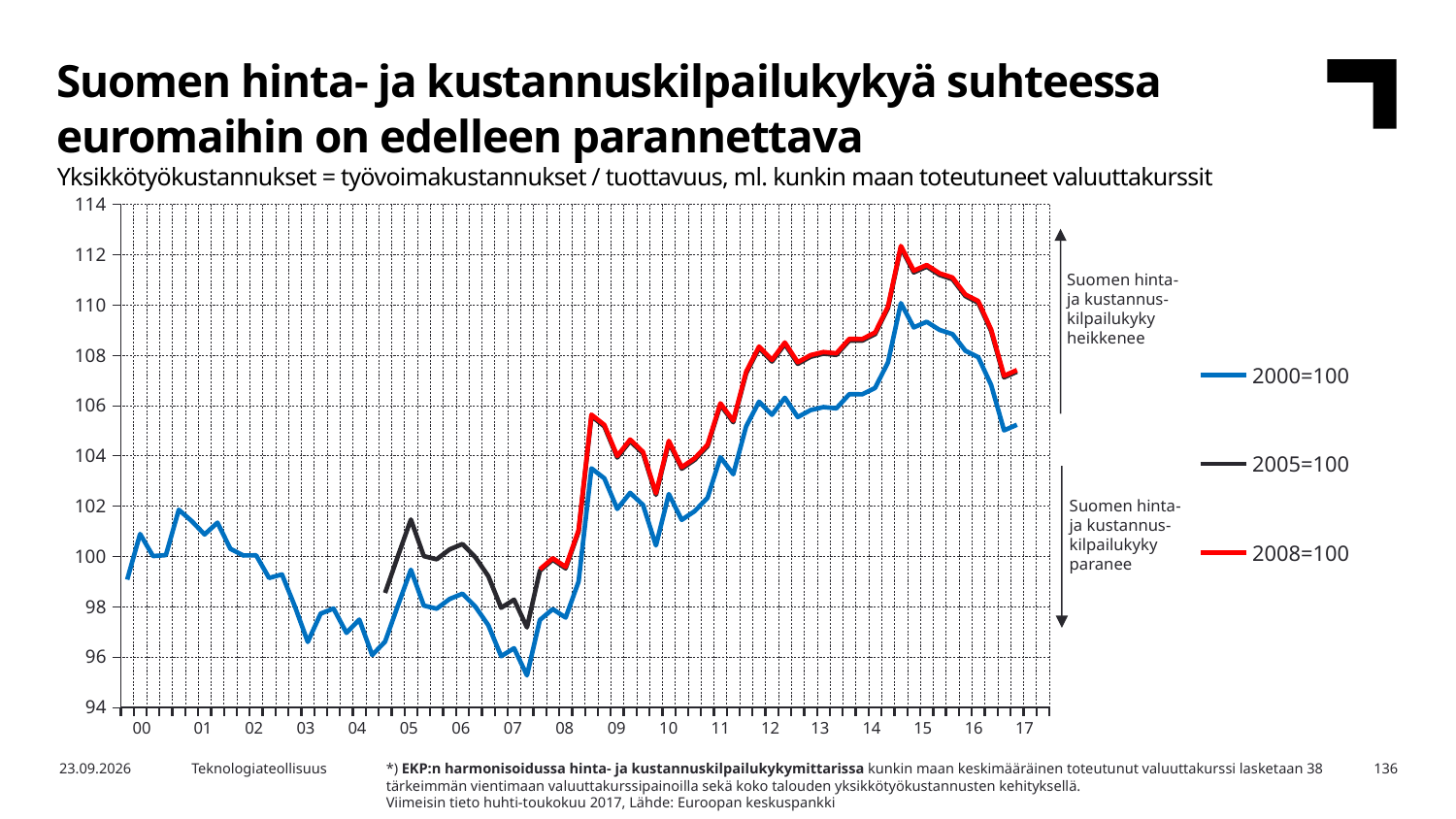
Is the value of the 2000=100 series during 2003 greater or less than 100? less Is the final value of the 2000=100 series in 2017 greater or less than 104? greater How many year labels are shown on the x axis? 18 Does the 2000=100 series rise or fall between 2008 and 2014? rise What are the three series named in the legend? 2000=100, 2005=100, 2008=100 Is the lowest value of the 2000=100 series, reached around 2007, greater or less than 97? less In 2015, which series has the higher value, 2008=100 or 2000=100? 2008=100 What colour is the line for the 2008=100 series? red How many series does the legend list? 3 What kind of chart is shown on the slide? line chart Which series reaches the highest value anywhere on the chart? 2008=100